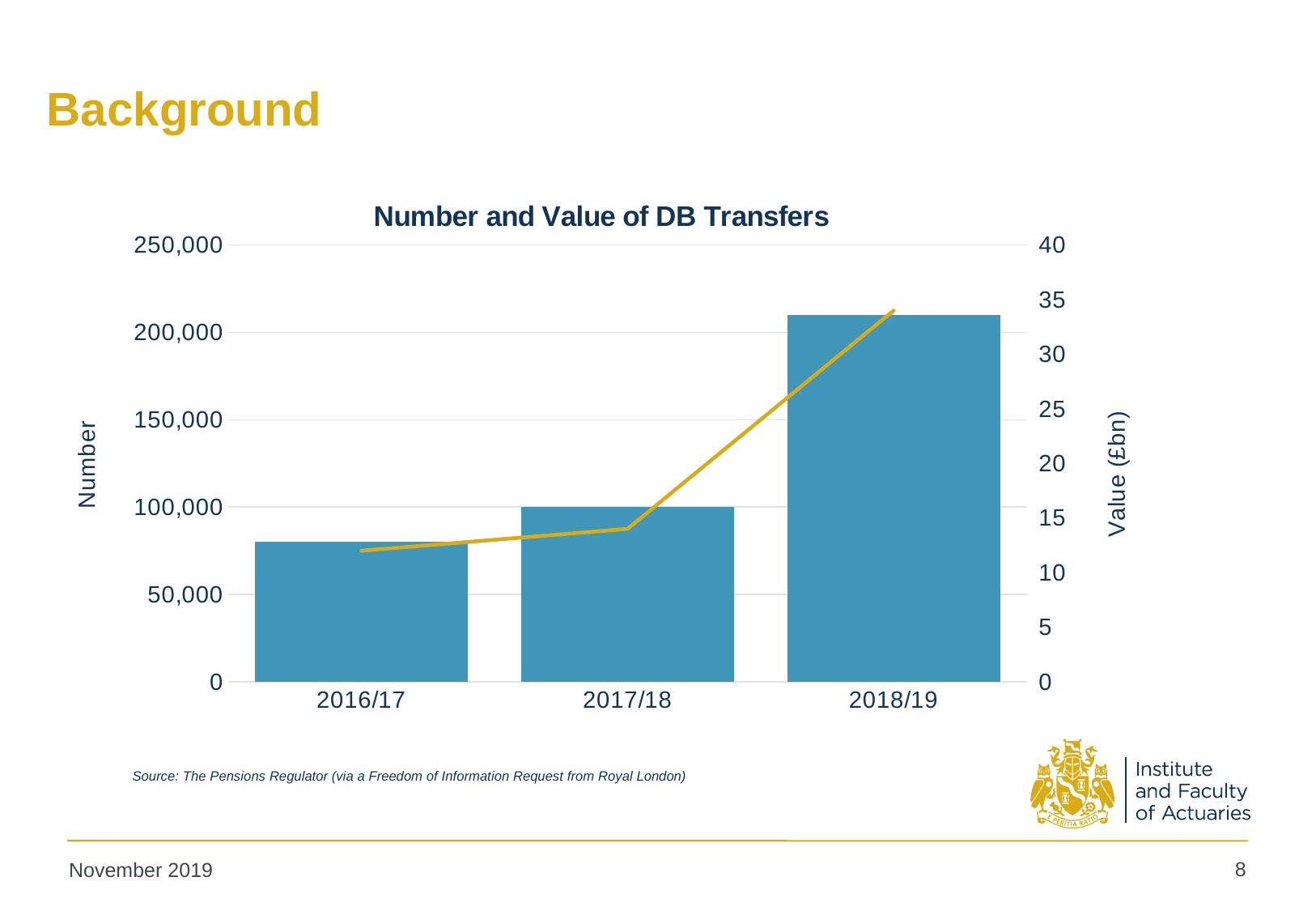
Does the number of DB transfers rise or fall from 2016/17 to 2018/19? rise Which year has the highest number of DB transfers? 2018/19 What is the title of the chart? Number and Value of DB Transfers How many years are shown on the x axis of the chart? 3 Which year has the larger number of DB transfers, 2016/17 or 2017/18? 2017/18 Is the number of DB transfers for 2018/19 greater or less than 200,000? greater Is the number of DB transfers for 2016/17 greater or less than 100,000? less What kind of chart is shown on the slide? A bar chart with a line Is the value of DB transfers (£bn) for 2018/19 greater or less than 30? greater Which year has the lowest number of DB transfers? 2016/17 What is the label on the right-hand vertical axis of the chart? Value (£bn)